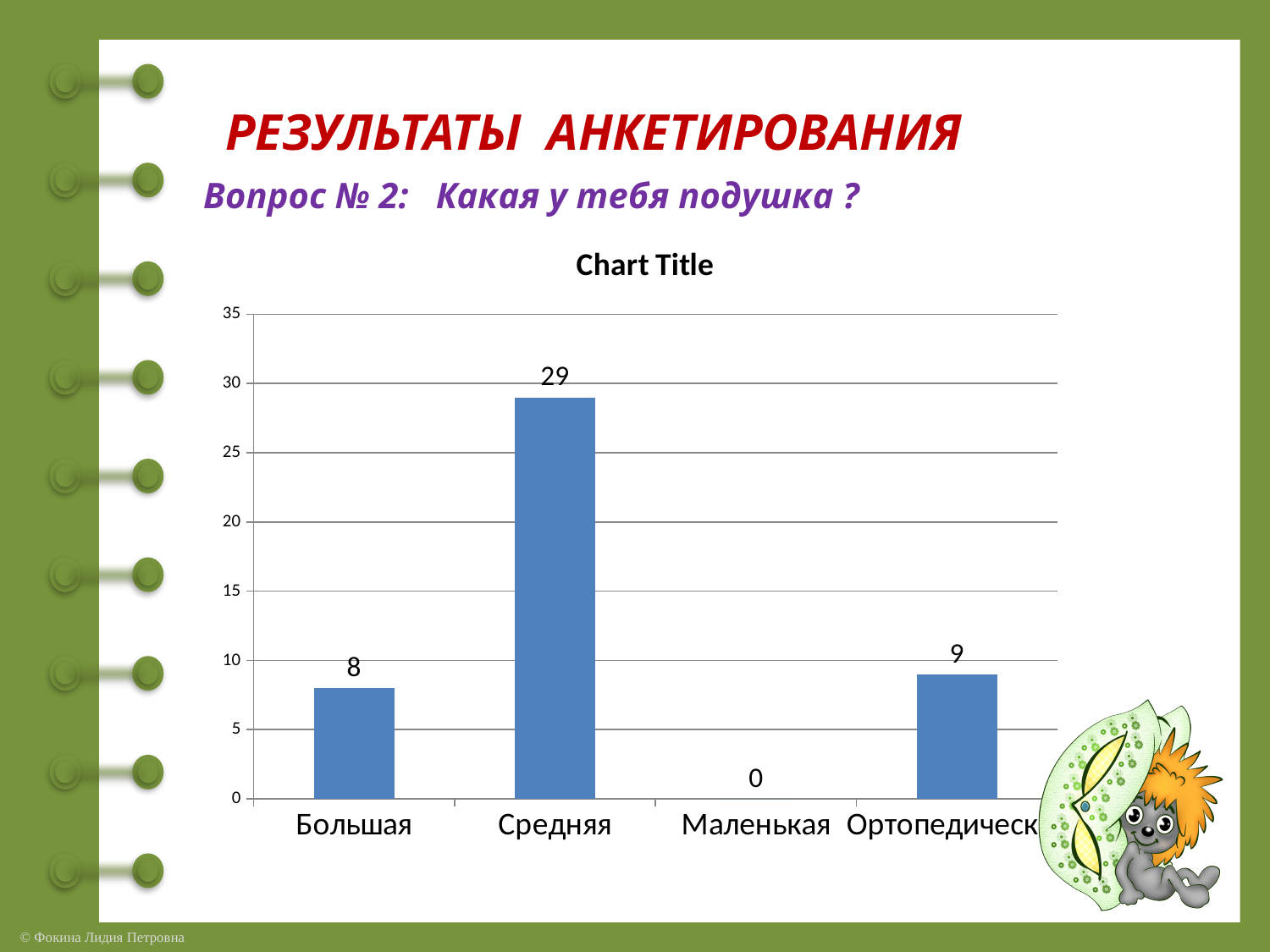
How many categories are shown on the x axis? 4 Which category has the highest value? Средняя What kind of chart is shown on the slide? bar chart What value is shown for the rightmost bar, labelled Ортопедическ…? 9 What value is shown for Большая? 8 What is the title printed above the chart? Chart Title What is the difference between the values for Средняя and Большая? 21 What value is shown for Маленькая? 0 What value is shown for Средняя? 29 Which category has the lowest value? Маленькая Which is larger, the value for Большая or the value for the rightmost bar (Ортопедическ…)? Ортопедическ… Is the value for Средняя greater or less than 25? greater